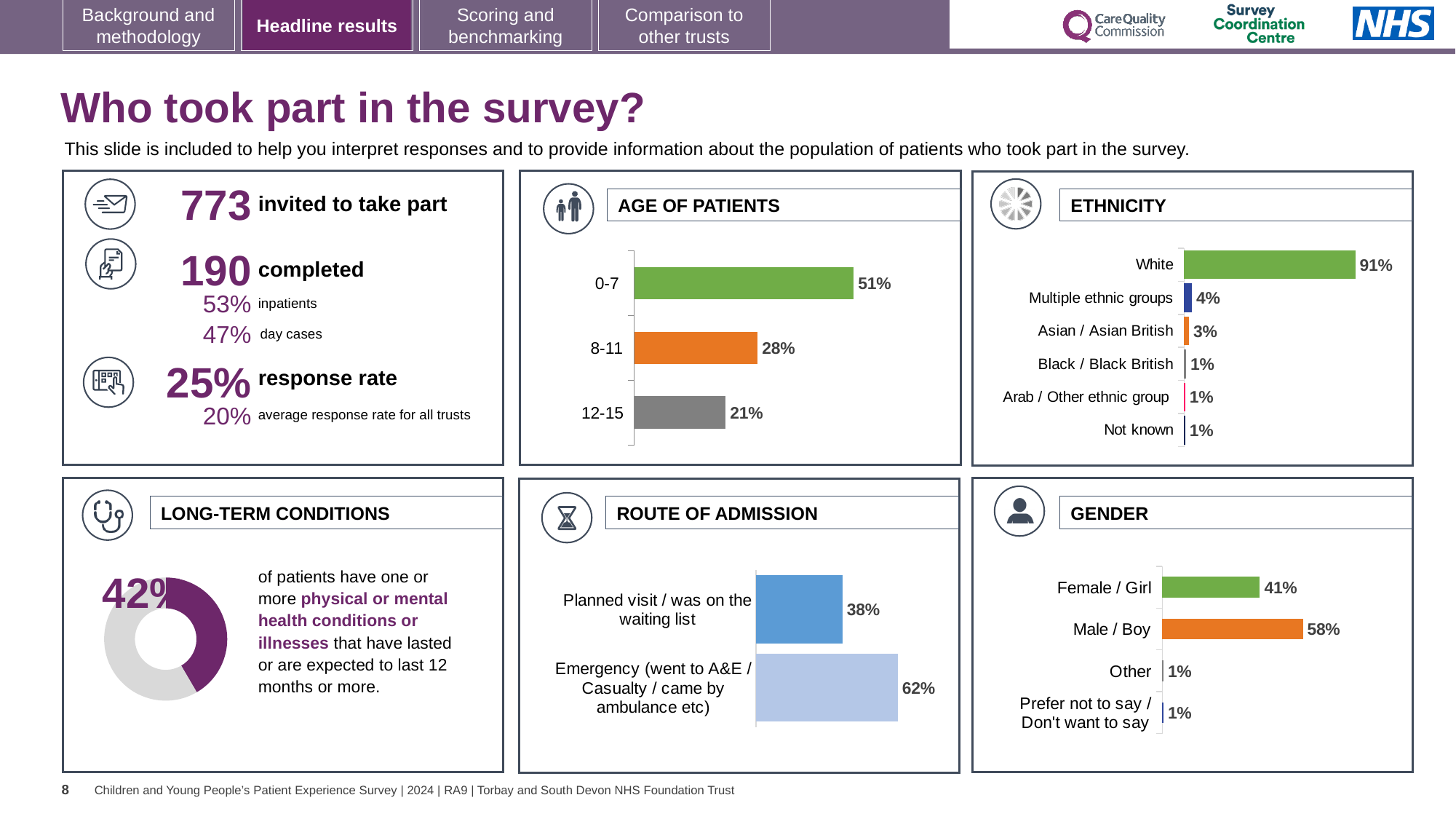
In the LONG-TERM CONDITIONS chart, what percentage of patients have one or more long-term conditions? 42% In the ETHNICITY chart, what percentage of patients were White? 91% What type of chart is used in the LONG-TERM CONDITIONS panel? Doughnut chart In the ROUTE OF ADMISSION chart, what is the difference between the Emergency and Planned visit percentages? 24% In the ROUTE OF ADMISSION chart, what percentage of patients came via Emergency (went to A&E / Casualty / came by ambulance etc)? 62% In the AGE OF PATIENTS chart, what is the difference between the 0-7 and 8-11 percentages? 23% In the ETHNICITY chart, which is larger, Multiple ethnic groups or Asian / Asian British? Multiple ethnic groups In the GENDER chart, what percentage of patients were Female / Girl? 41% In the AGE OF PATIENTS chart, which age group has the lowest percentage? 12-15 In the ETHNICITY chart, how many ethnicity categories are shown? 6 In the AGE OF PATIENTS chart, what percentage of patients were aged 0-7? 51% In the GENDER chart, which category has the highest percentage? Male / Boy